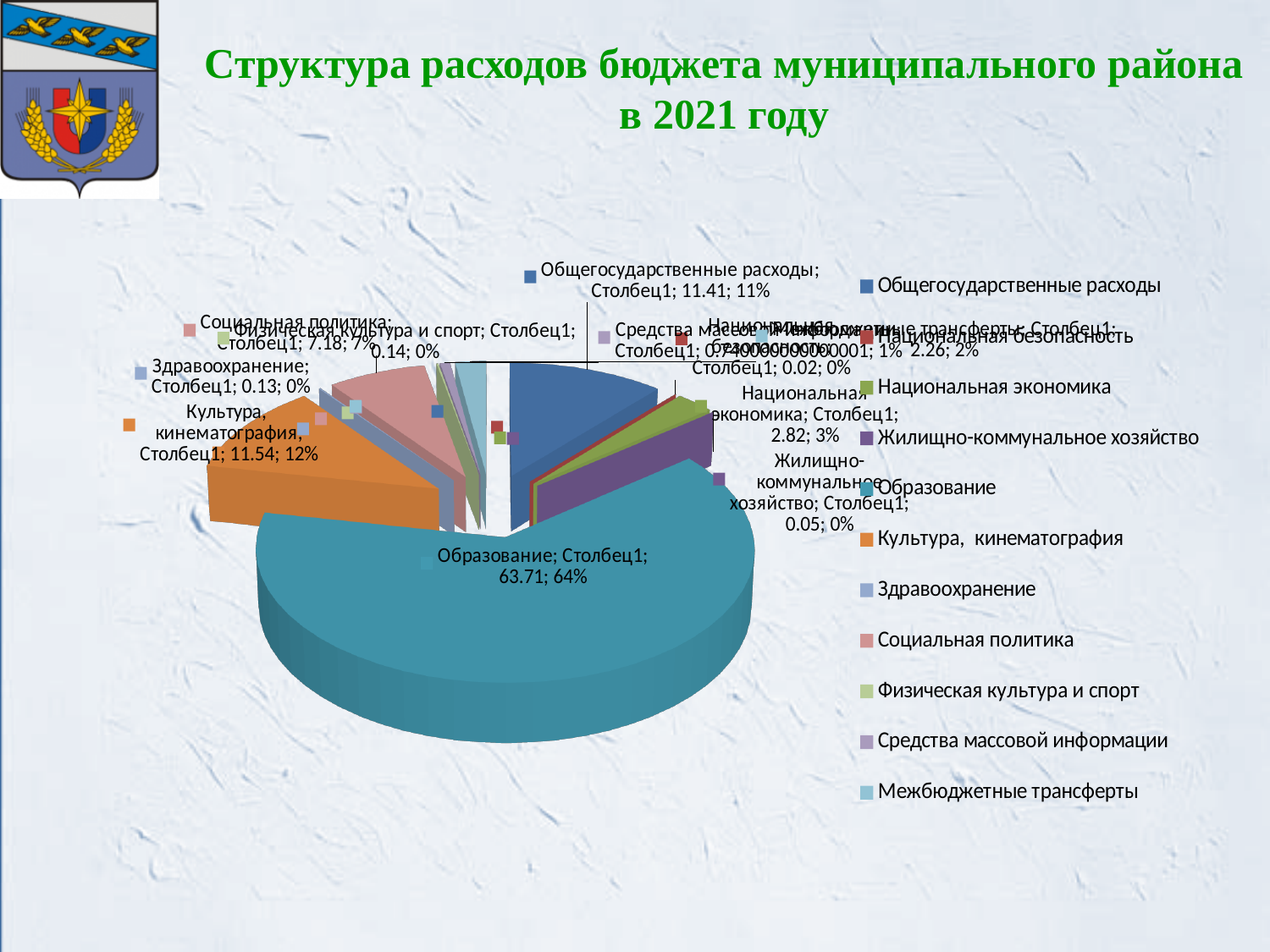
What value is shown for Образование in the pie chart? 63.71 What percentage share does Образование have in the pie chart? 64% What value is shown for Общегосударственные расходы? 11.41 What kind of chart is shown on the slide? pie chart Which category has the largest slice of the pie chart? Образование What is the difference between the values for Образование and Общегосударственные расходы? 52.30 What percentage share does Социальная политика have? 7% What is the title of the chart on the slide? Структура расходов бюджета муниципального района в 2021 году What value is shown for Культура, кинематография? 11.54 Which is larger, the value for Культура, кинематография or the value for Социальная политика? Культура, кинематография How many categories does the legend of the pie chart list? 11 What value is shown for Национальная экономика? 2.82